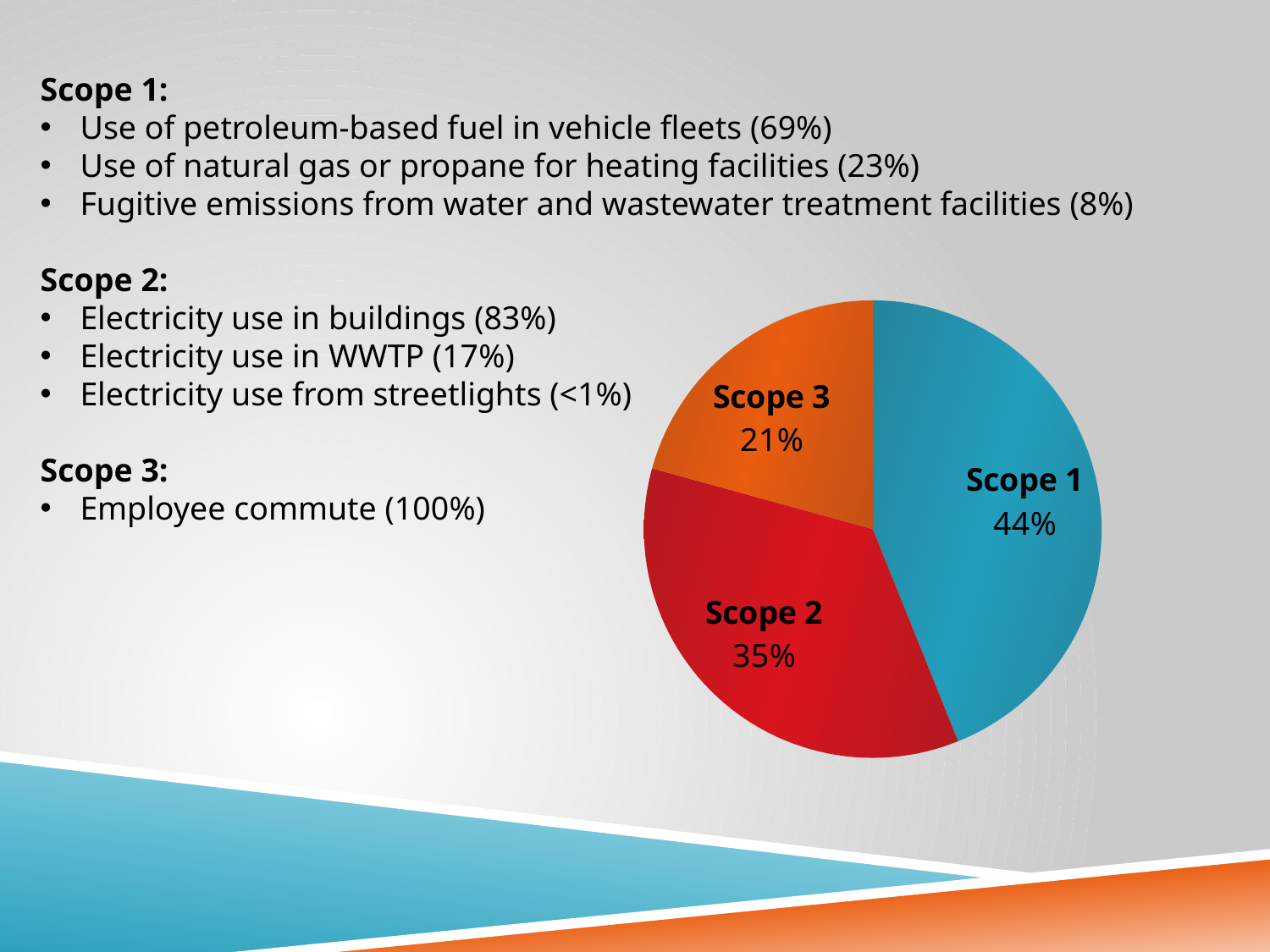
What kind of chart is shown on the slide? pie chart What percentage of the pie does Scope 3 represent? 21% Which scope has the smallest slice of the pie? Scope 3 What colour is the Scope 1 slice of the pie? blue What is the difference in percentage points between Scope 2 and Scope 3? 14 How many slices does the pie chart have? 3 What percentage of the pie does Scope 1 represent? 44% Which is larger, the Scope 2 slice or the Scope 3 slice? Scope 2 What percentage of the pie does Scope 2 represent? 35% Which scope has the largest slice of the pie? Scope 1 What colour is the Scope 3 slice of the pie? orange What is the difference in percentage points between Scope 1 and Scope 2? 9